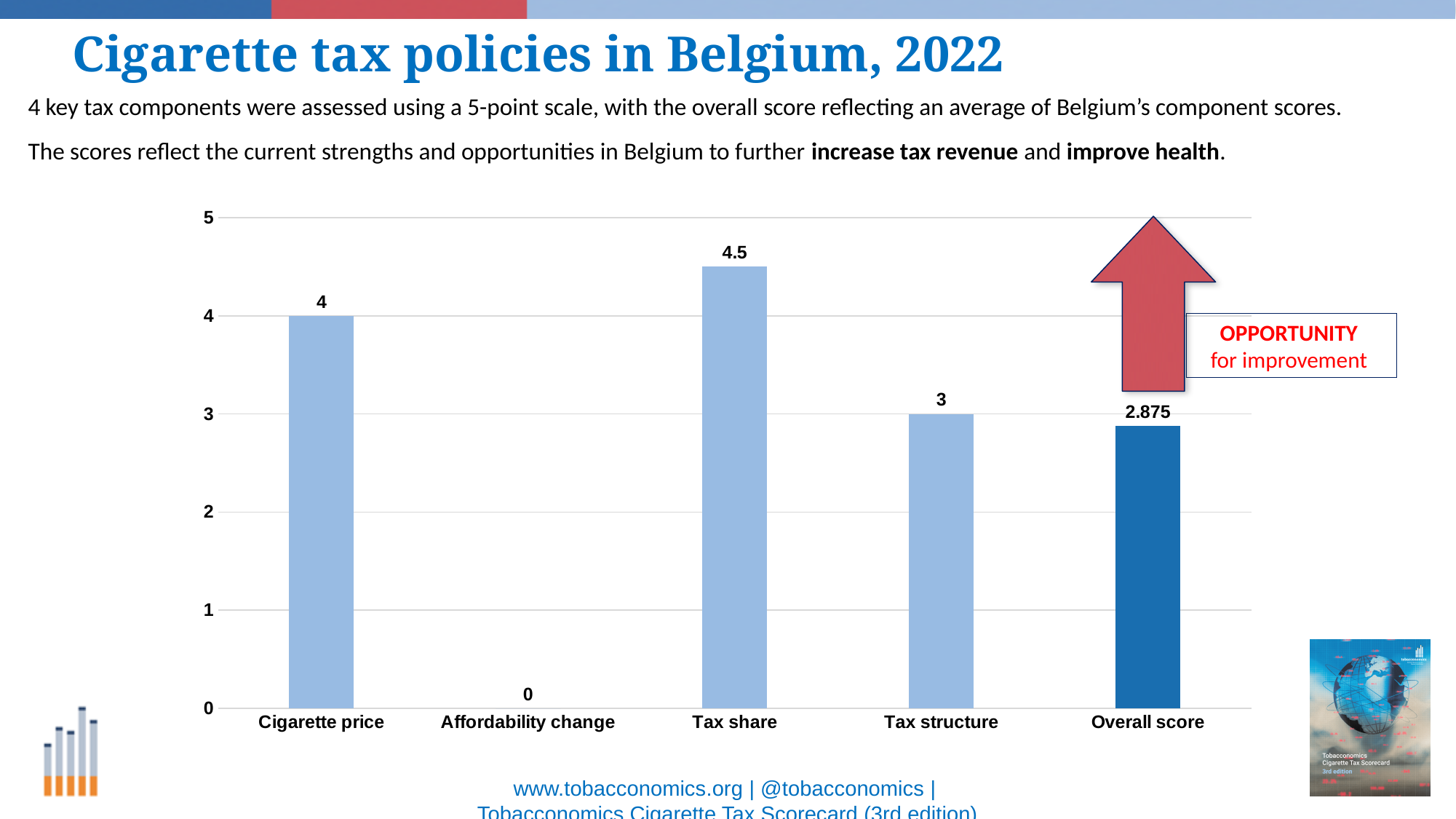
What is the difference between the values for Tax share and Tax structure? 1.5 Is the value for Overall score greater or less than 3? less What kind of chart is shown on the slide? bar chart Which bar is drawn in a darker blue than the others? Overall score How many categories are shown on the x axis? 5 Which category has the highest value? Tax share What is the Overall score shown in the chart? 2.875 What is the value for Tax share? 4.5 What is the value for Affordability change? 0 What is the value for Cigarette price? 4 Which is larger, the value for Cigarette price or the value for Tax structure? Cigarette price Which category has the lowest value? Affordability change